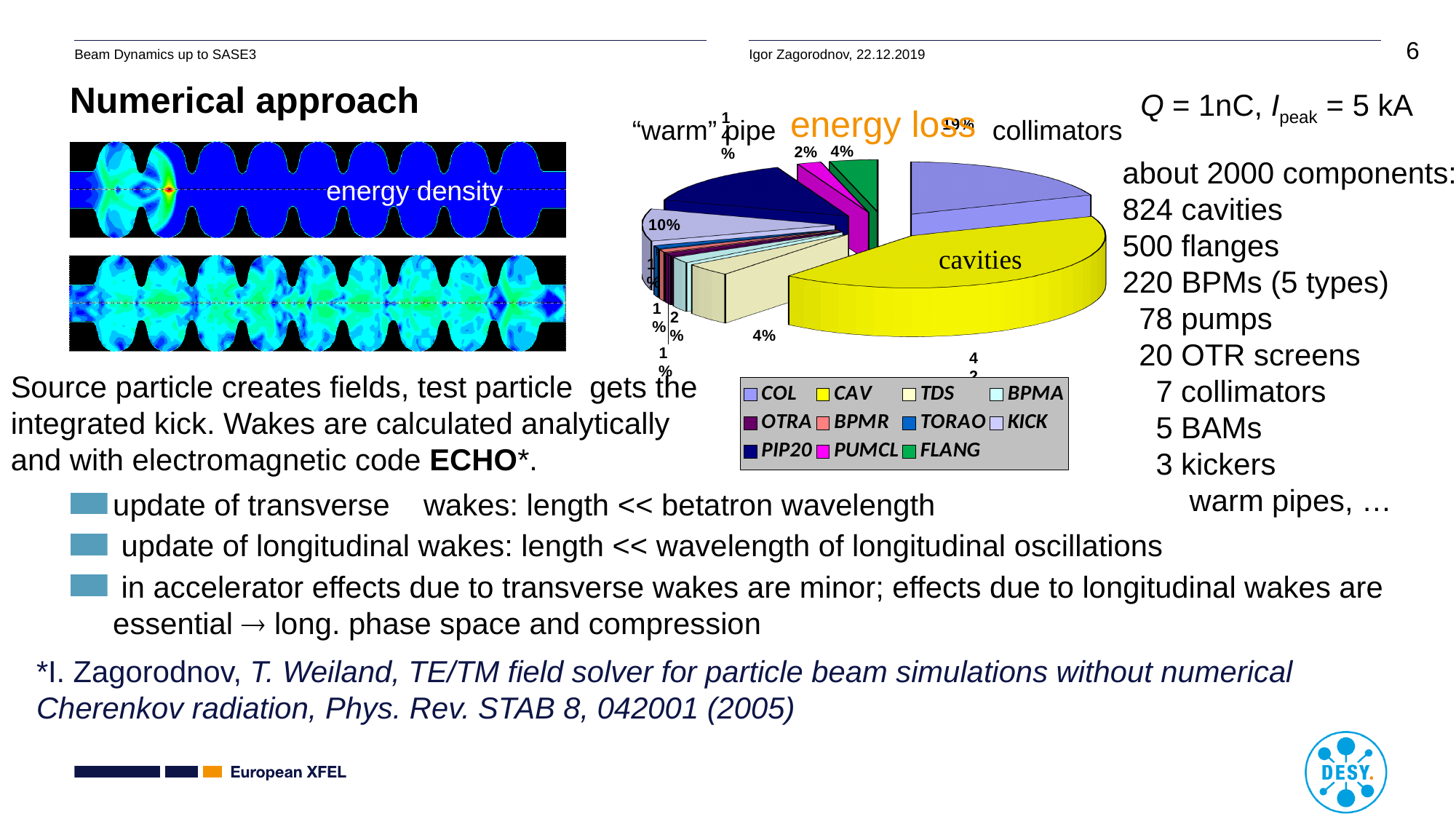
In the "energy loss" pie chart, what is the difference between the PIP20 share and the FLANG share? 10% What colour is the CAV slice in the "energy loss" pie chart? yellow What is the title of the pie chart on the slide? energy loss What kind of chart is the "energy loss" chart? pie chart In the "energy loss" pie chart, which slice is larger, CAV or COL? CAV What percentage is shown for the PUMCL slice in the "energy loss" pie chart? 2% What percentage is shown for the PIP20 slice in the "energy loss" pie chart? 14% In the "energy loss" pie chart, which slice is larger, PIP20 or FLANG? PIP20 How many entries does the legend of the "energy loss" pie chart list? 11 What percentage is shown for the FLANG slice in the "energy loss" pie chart? 4% Which category has the largest slice in the "energy loss" pie chart? CAV What percentage is shown for the TDS slice in the "energy loss" pie chart? 4%